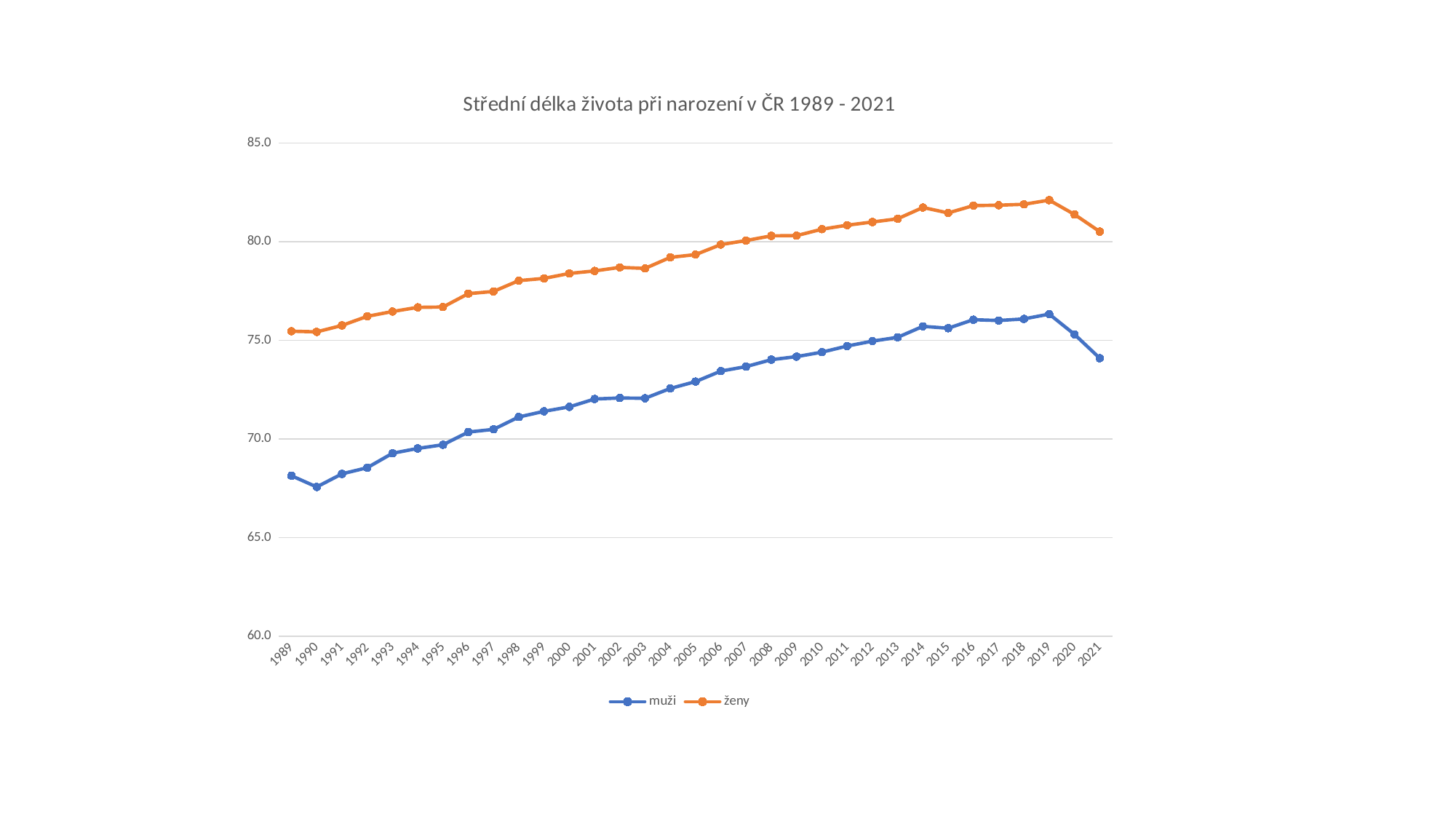
In which year does the muži series have its lowest value? 1990 Is the value for muži in 2021 greater or less than 75? less Which is larger: the value for muži in 2020 or in 2021? 2020 What kind of chart is shown on the slide? line chart What is the title of the chart? Střední délka života při narození v ČR 1989 - 2021 Does the ženy series generally rise or fall between 1989 and 2019? rise How many series does the legend list? 2 Is the value for ženy in 2019 greater or less than 80? greater Is the value for muži in 1989 greater or less than 70? less How many years are plotted along the x axis? 33 In which year does the muži series reach its highest value? 2019 In which year does the ženy series reach its highest value? 2019